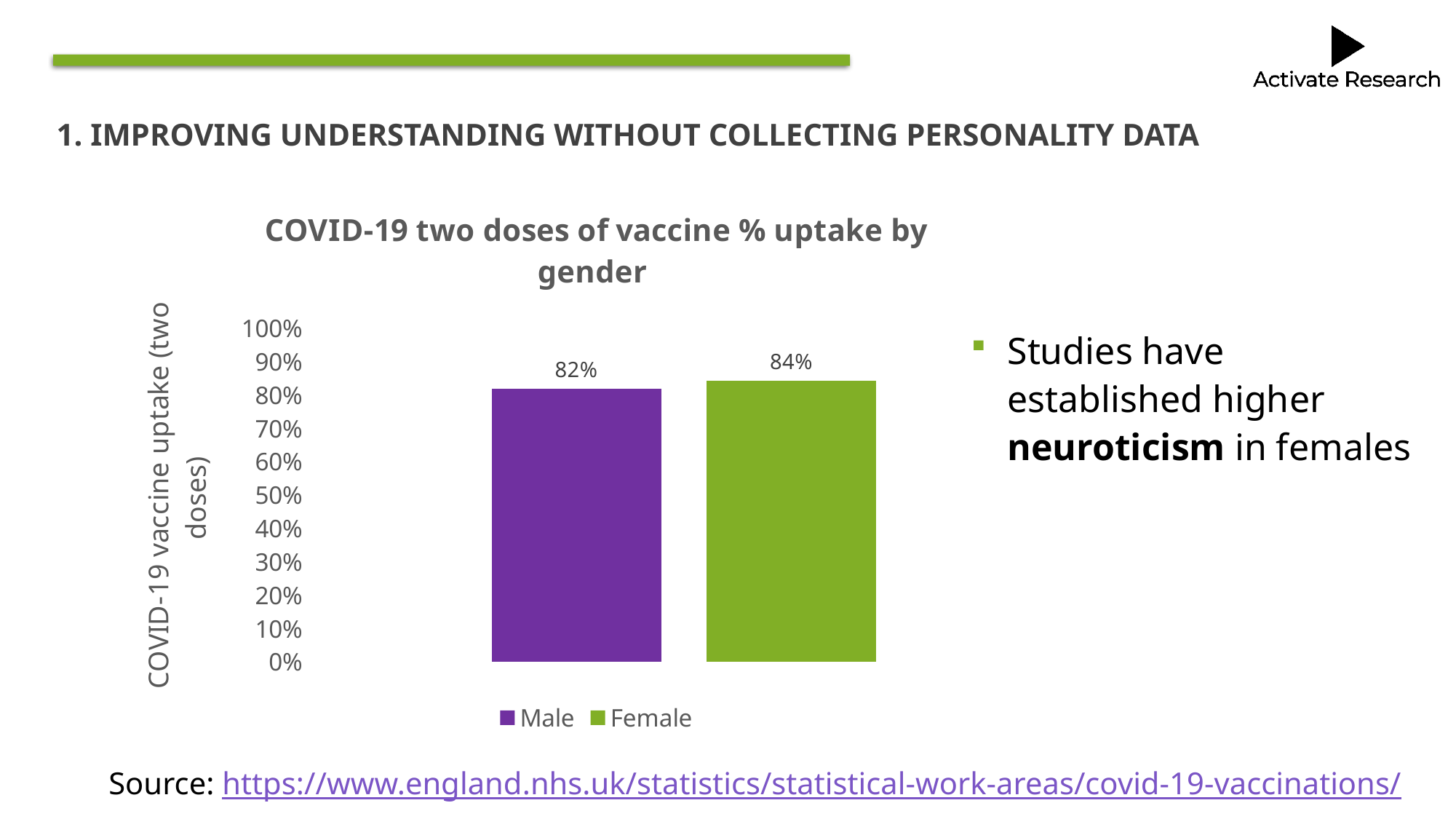
What is the COVID-19 two-dose vaccine uptake for Female? 84% What is the title of the chart? COVID-19 two doses of vaccine % uptake by gender What colour is the Female bar in the chart? Green Which group has the higher two-dose vaccine uptake, Male or Female? Female Which group has the lowest two-dose vaccine uptake? Male How many series does the legend list? 2 Is the two-dose vaccine uptake for Female greater or less than 80%? greater What is the difference in two-dose vaccine uptake between Female and Male? 2% What kind of chart is shown on the slide? Bar chart How many bars are plotted in the chart? 2 Is the two-dose vaccine uptake for Male greater or less than 90%? less What is the COVID-19 two-dose vaccine uptake for Male? 82%